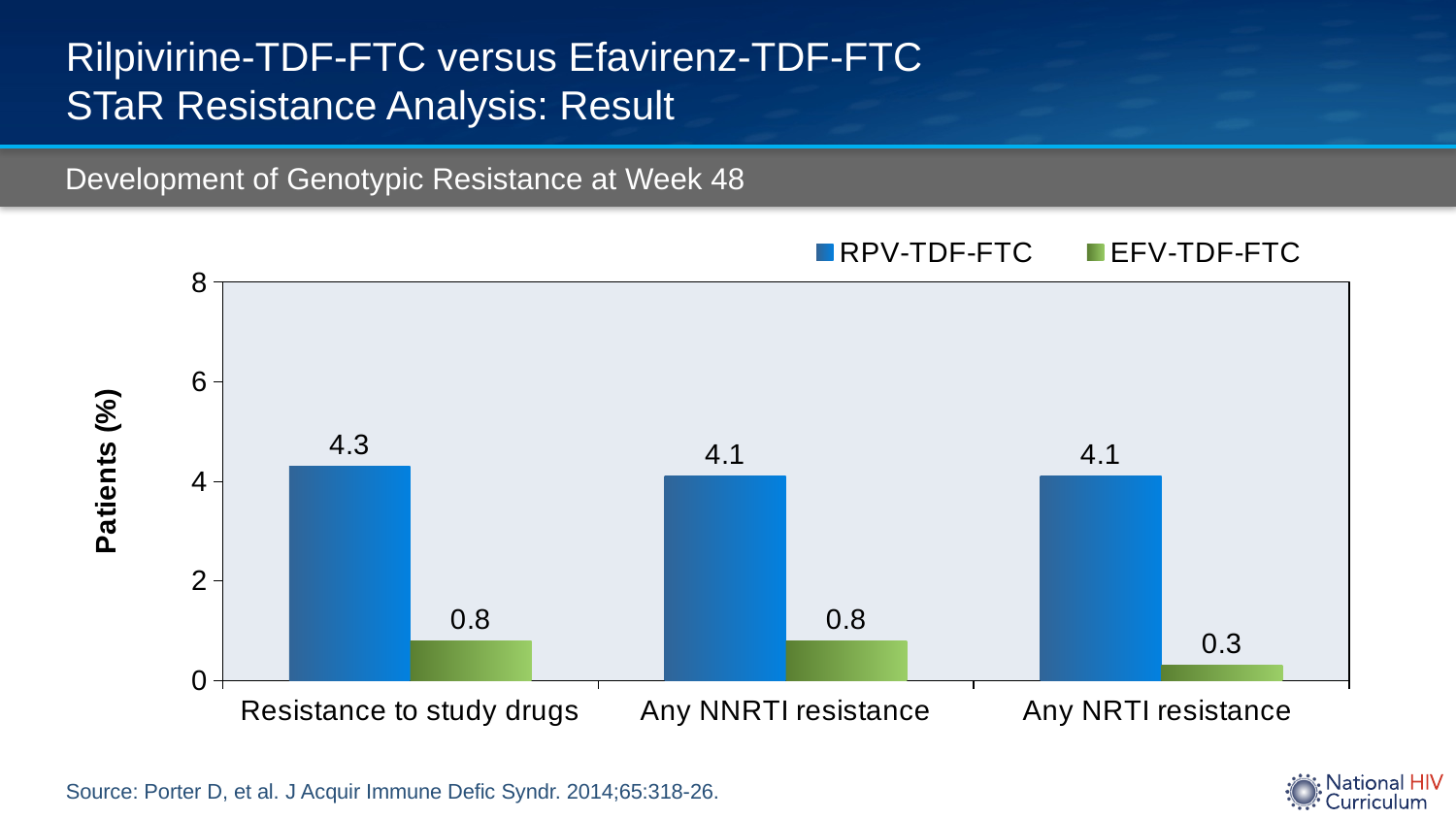
Which category has the highest value for RPV-TDF-FTC? Resistance to study drugs In the Any NNRTI resistance category, which series has the larger value, RPV-TDF-FTC or EFV-TDF-FTC? RPV-TDF-FTC Which category has the lowest value for EFV-TDF-FTC? Any NRTI resistance What is the value for RPV-TDF-FTC in the Resistance to study drugs category? 4.3 What is the difference between the RPV-TDF-FTC and EFV-TDF-FTC values in the Any NRTI resistance category? 3.8 What is the value for RPV-TDF-FTC in the Any NRTI resistance category? 4.1 What is the value for EFV-TDF-FTC in the Any NRTI resistance category? 0.3 How many series does the legend list? 2 What is the value for EFV-TDF-FTC in the Any NNRTI resistance category? 0.8 What is the difference between the RPV-TDF-FTC and EFV-TDF-FTC values in the Resistance to study drugs category? 3.5 How many categories are shown on the x axis? 3 What kind of chart is shown on the slide? Bar chart